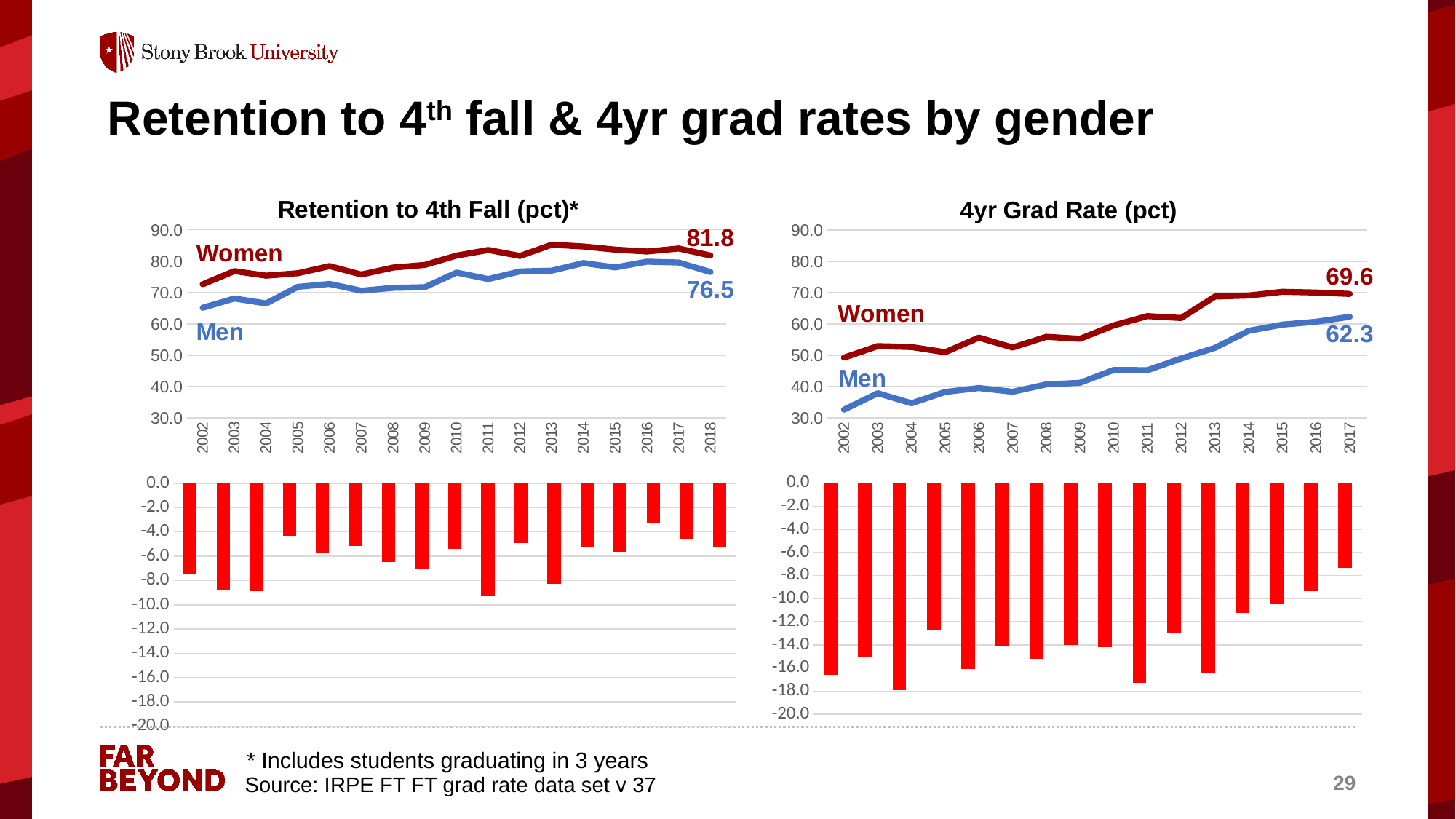
In the 4yr Grad Rate (pct) chart, does the Men series generally rise or fall from 2002 to 2017? rise In the Retention to 4th Fall (pct)* chart, what is the labeled value for Women in 2018? 81.8 In the 4yr Grad Rate (pct) chart, which series is higher in 2017, Women or Men? Women How many years are shown on the x axis of the 4yr Grad Rate (pct) chart? 16 In the bar chart below the 4yr Grad Rate (pct) chart, which year has the lowest (most negative) bar? 2004 In the 4yr Grad Rate (pct) chart, what is the labeled value for Men in 2017? 62.3 In the Retention to 4th Fall (pct)* chart, is the value for Men in 2002 greater or less than 70.0? less In the 4yr Grad Rate (pct) chart, what is the labeled value for Women in 2017? 69.6 In the 4yr Grad Rate (pct) chart, is the value for Men in 2002 greater or less than 40.0? less In the Retention to 4th Fall (pct)* chart, what is the difference between the 2018 values for Women and Men? 5.3 In the Retention to 4th Fall (pct)* chart, what is the labeled value for Men in 2018? 76.5 In the 4yr Grad Rate (pct) chart, what is the difference between the 2017 values for Women and Men? 7.3